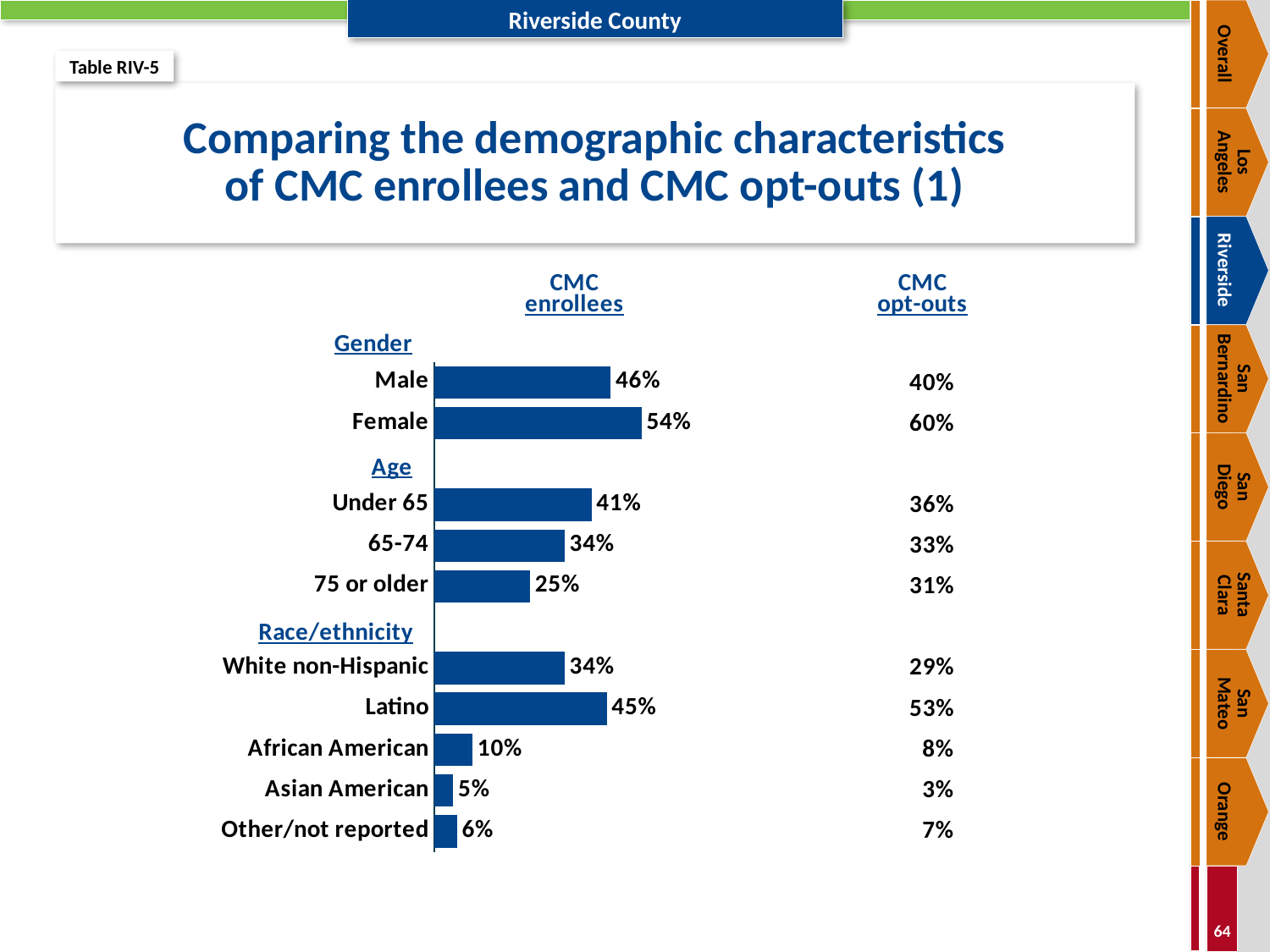
What is the table label shown in the top-left corner of the slide? Table RIV-5 Which is larger among CMC enrollees: the Under 65 share or the 65-74 share? Under 65 What type of chart is used to show the CMC enrollees percentages? Bar chart What percentage of CMC enrollees are Asian American? 5% Which race/ethnicity category has the lowest percentage of CMC enrollees? Asian American What is the difference between the Female and Male percentages of CMC enrollees? 8% How many bars are plotted in the CMC enrollees chart? 10 What percentage of CMC enrollees are Latino? 45% Which race/ethnicity category has the highest percentage of CMC enrollees? Latino What percentage of CMC enrollees are 75 or older? 25% What percentage of CMC enrollees are Male? 46% Do the CMC enrollee percentages rise or fall across the age groups from Under 65 to 75 or older? Fall